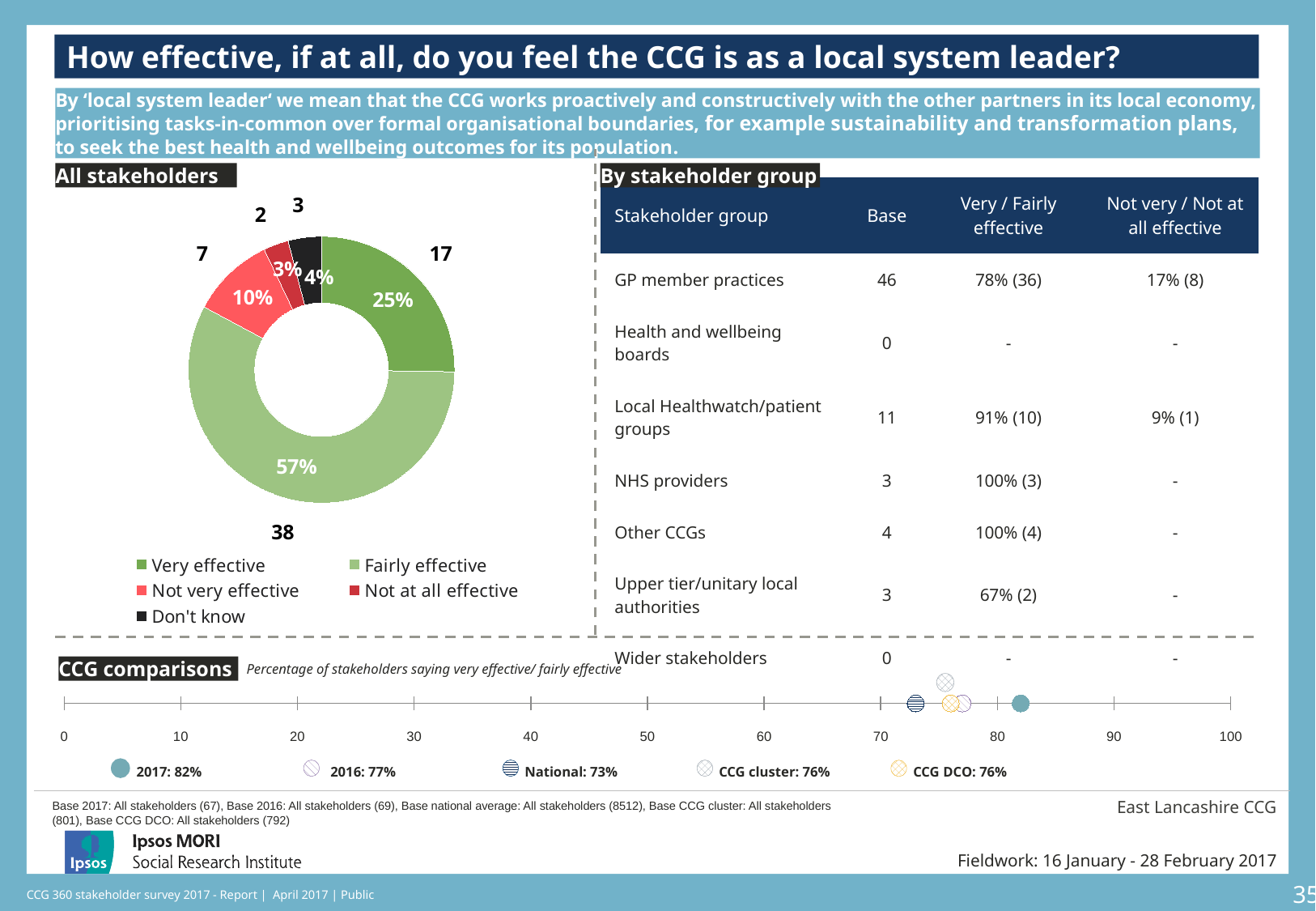
In the 'All stakeholders' donut chart, which is larger: the share for 'Don't know' or the share for 'Not at all effective'? Don't know How many response categories does the legend of the 'All stakeholders' donut chart list? 5 In the 'All stakeholders' donut chart, what percentage of stakeholders said the CCG is fairly effective? 57% What type of chart is used for the 'All stakeholders' results? Donut (pie) chart In the 'All stakeholders' donut chart, which response category has the largest share? Fairly effective In the 'All stakeholders' donut chart, which response category has the smallest share? Not at all effective In the 'CCG comparisons' chart, what is the difference in percentage points between the 2017 and 2016 values? 5 In the 'All stakeholders' donut chart, how many stakeholders said 'Not very effective'? 7 In the 'All stakeholders' donut chart, what percentage of stakeholders said the CCG is very effective? 25% In the 'CCG comparisons' chart, what percentage of stakeholders said very/fairly effective in 2017? 82% In the 'CCG comparisons' chart, what is the National value? 73% In the 'All stakeholders' donut chart, what is the difference in percentage points between 'Fairly effective' and 'Very effective'? 32